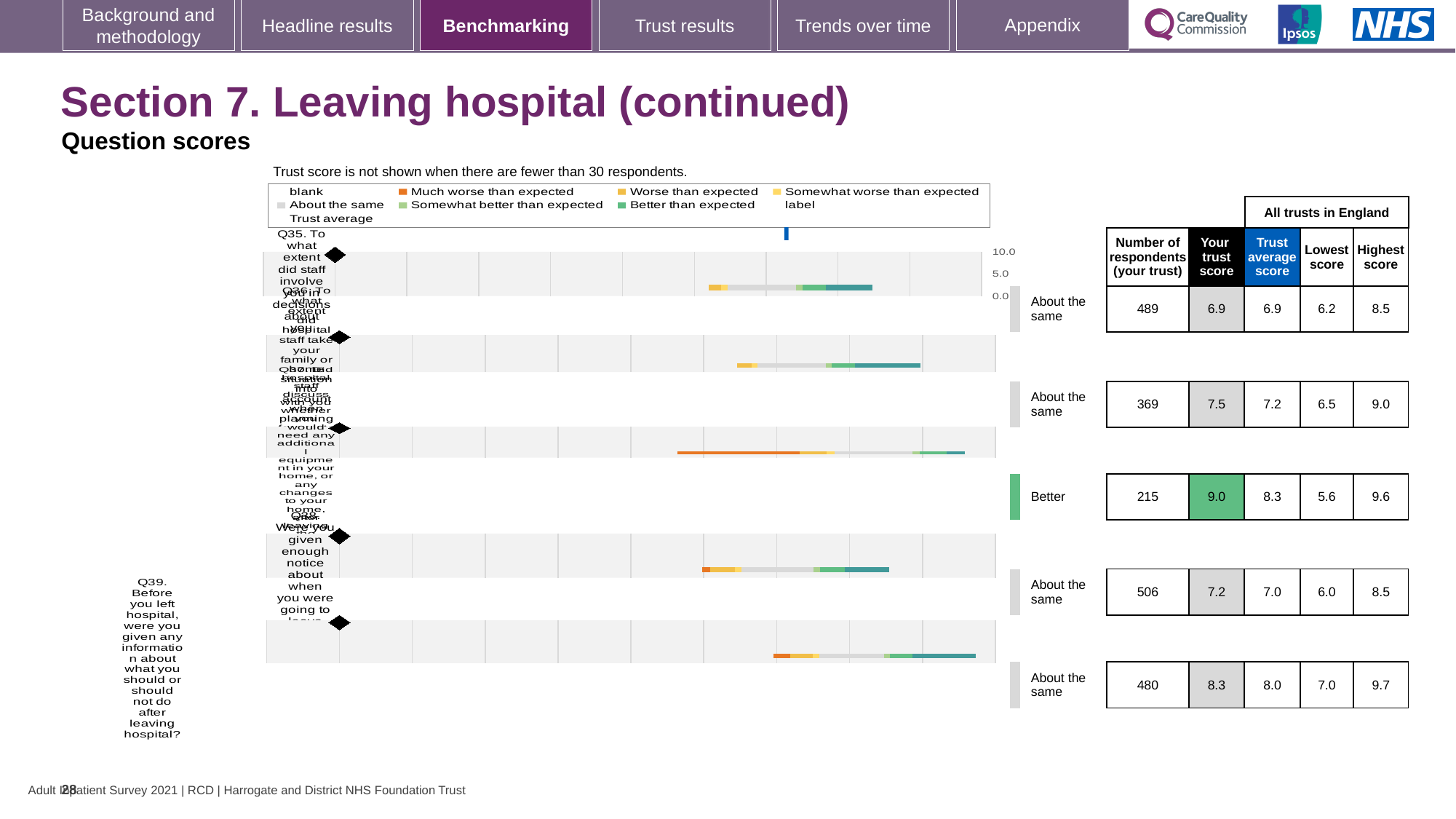
What is the smallest number of respondents shown for any question in the table? 215 How many questions are plotted in the question scores chart? 5 What is the difference between the 'Your trust score' and the 'Trust average score' for Q39? 0.3 How many of the questions on this slide are rated 'Better' rather than 'About the same'? 1 What is the highest 'Your trust score' shown in the table? 9.0 How many respondents from your trust answered Q35 (to what extent did staff involve you in decisions about leaving hospital)? 489 What is the 'Lowest score' across all trusts in England for Q35? 6.2 Is the 'Your trust score' for Q35 greater or less than 5.0? greater What is the 'Your trust score' for Q39 (information about what you should or should not do after leaving hospital)? 8.3 For Q38 (were you given enough notice about when you were going to leave hospital), which is larger: the 'Your trust score' or the 'Trust average score'? Your trust score What is the 'Highest score' across all trusts in England for Q39? 9.7 What kind of chart is used to show the question scores on this slide? bar chart